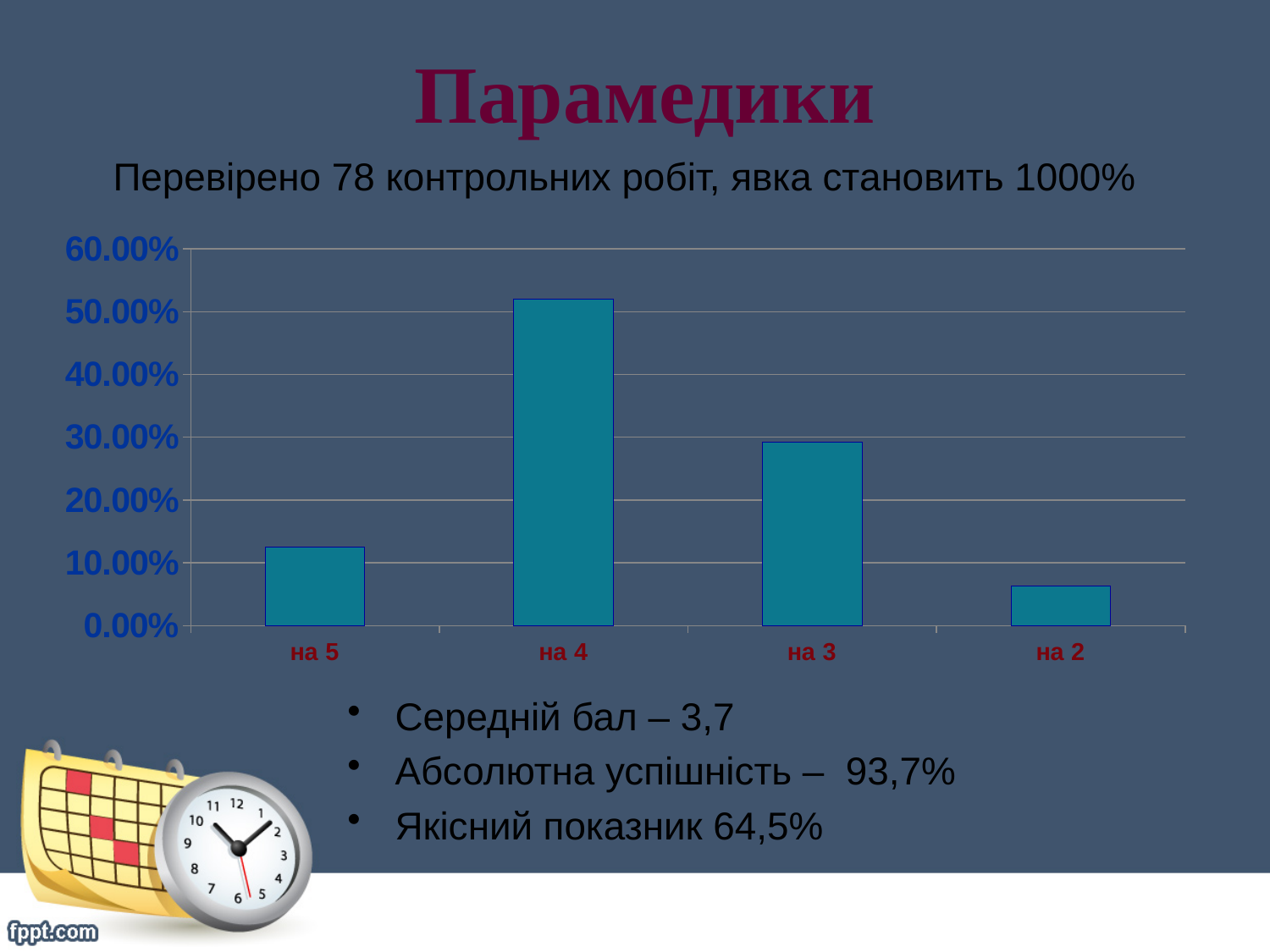
What kind of chart is shown on the slide? bar chart Is the value for на 4 greater or less than 40.00%? greater Is the value for на 5 greater or less than 20.00%? less How many categories are shown on the x axis of the chart? 4 Which category has the highest bar in the chart? на 4 Which is larger, the value for на 5 or the value for на 2? на 5 Is the value for на 2 greater or less than 10.00%? less What is the title of the slide containing the chart? Парамедики Which is larger, the value for на 3 or the value for на 5? на 3 Which category has the lowest bar in the chart? на 2 What is the highest value shown on the y axis of the chart? 60.00%